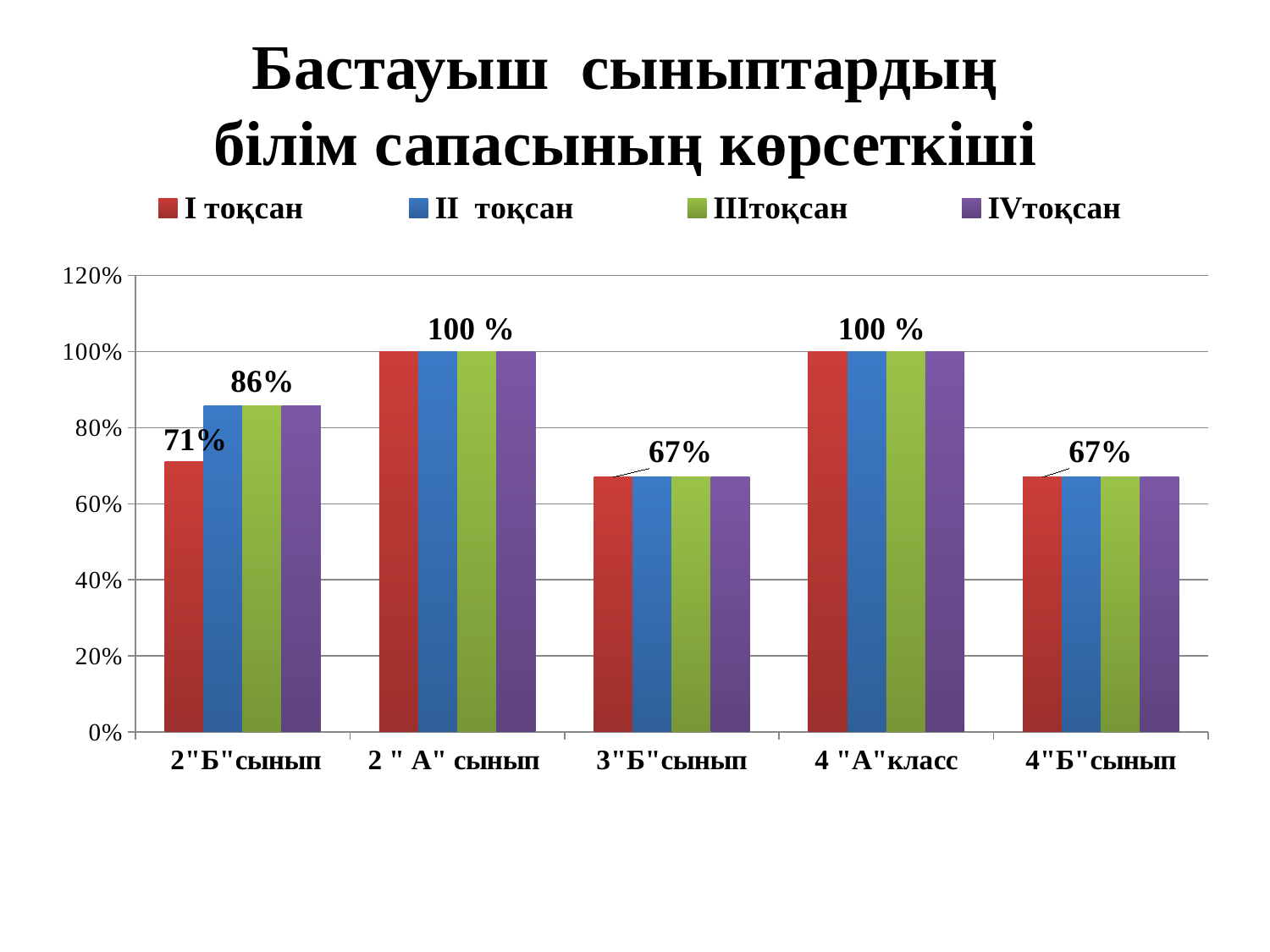
Is the value for IVтоқсан in 4"Б"сынып greater or less than 60%? greater How many categories (classes) are shown on the x axis? 5 What is the value for II тоқсан in 2"Б"сынып? 86% What is the value labelled for 4 "А"класс? 100 % Which is larger: the I тоқсан value for 2"Б"сынып or the I тоқсан value for 2 " А" сынып? 2 " А" сынып What is the value for I тоқсан in 2"Б"сынып? 71% What is the value labelled for 3"Б"сынып? 67% What is the value labelled for 2 " А" сынып? 100 % What kind of chart is shown on the slide? bar chart How many series does the legend list? 4 What is the difference between the II тоқсан value and the I тоқсан value for 2"Б"сынып? 15% Which series is listed first in the legend? I тоқсан